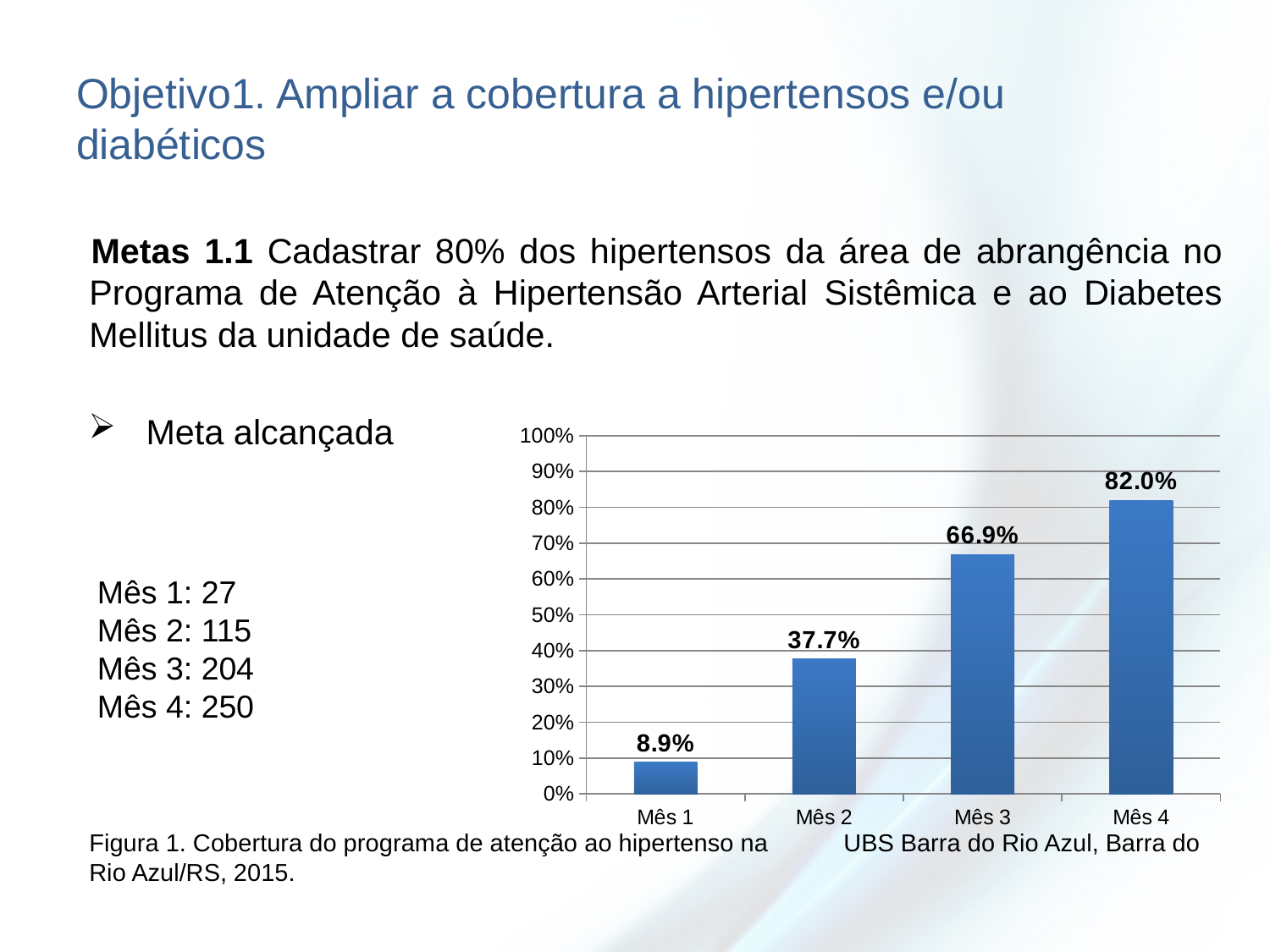
Which is larger, the value for Mês 2 or the value for Mês 3? Mês 3 Do the values rise or fall from Mês 1 to Mês 4? rise What is the value for Mês 1? 8.9% What is the value for Mês 3? 66.9% What is the difference between the values for Mês 4 and Mês 3? 15.1% What kind of chart is shown on the slide? bar chart What is the value for Mês 4? 82.0% How many months are shown on the x axis? 4 Is the value for Mês 4 greater or less than 80%? greater Which month has the lowest value? Mês 1 What is the difference between the values for Mês 2 and Mês 1? 28.8% Which month has the highest value? Mês 4